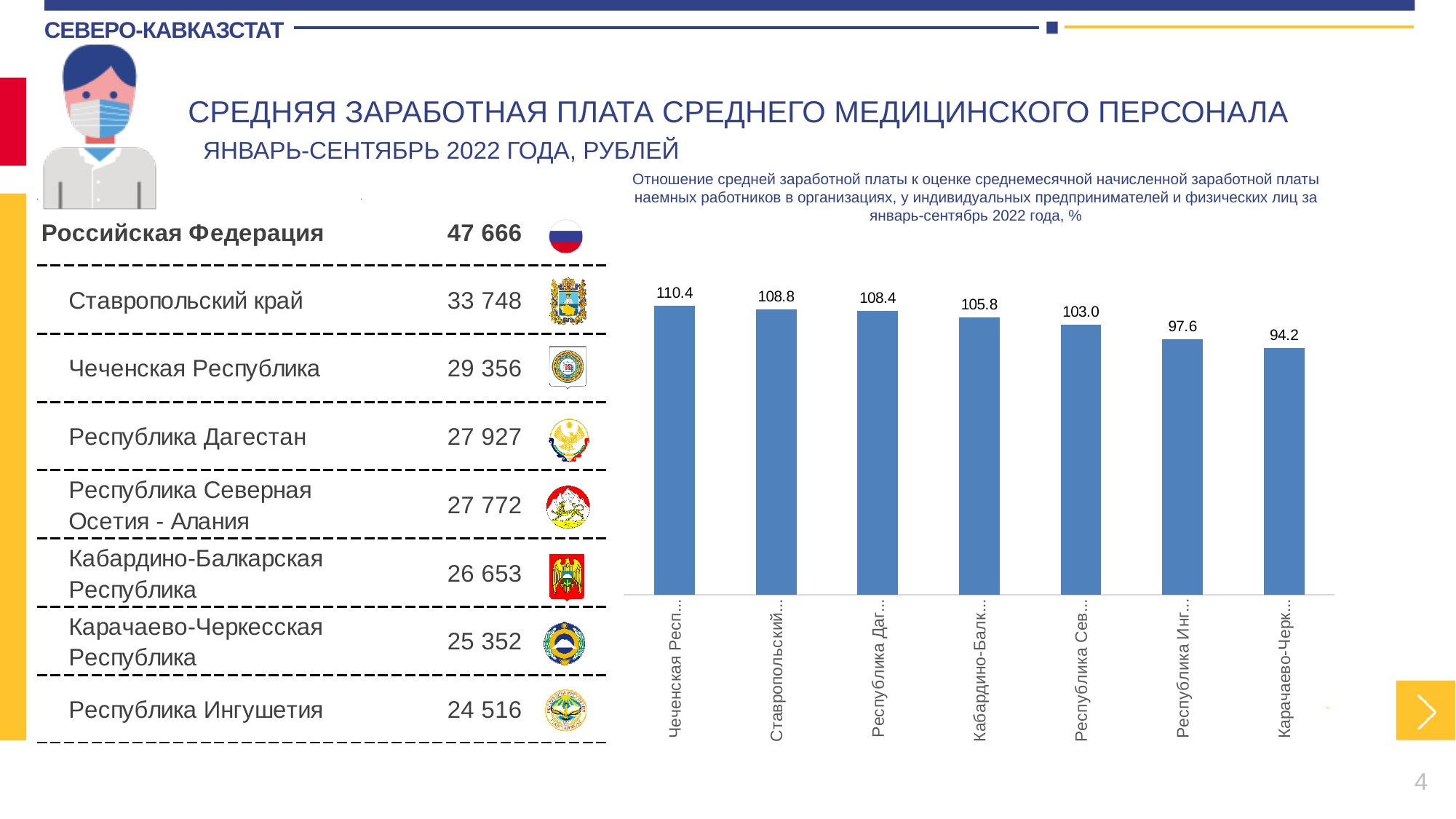
Which category has the highest value in the chart? Чеченская Респ... Do the values rise or fall from left to right across the chart? fall What is the value of the bar labelled "Ставропольский..."? 108.8 What is the value of the bar labelled "Республика Инг..."? 97.6 What is the difference between the values for "Чеченская Респ..." and "Карачаево-Черк..."? 16.2 Which category has the lowest value in the chart? Карачаево-Черк... What is the value of the bar labelled "Кабардино-Балк..."? 105.8 What is the value of the bar labelled "Чеченская Респ..."? 110.4 What type of chart is shown on the slide? bar chart What colour are the bars in the chart? blue Which is larger: the value for "Республика Даг..." or the value for "Республика Сев..."? Республика Даг... How many bars (categories) does the chart show? 7